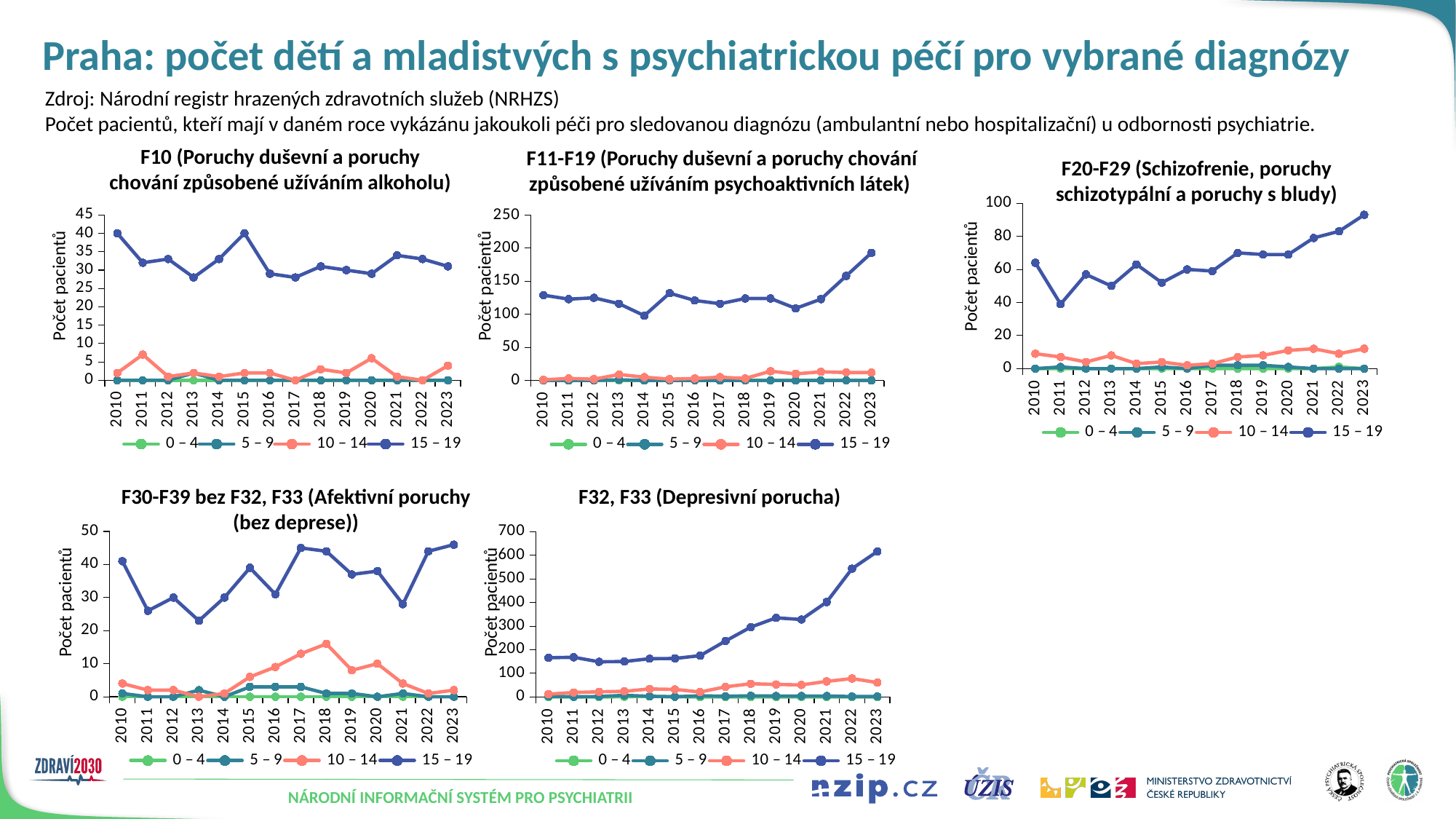
In the F32, F33 (Depresivní porucha) chart, does the 15 – 19 series rise or fall from 2016 to 2023? rise In the F11-F19 (Poruchy duševní a poruchy chování způsobené užíváním psychoaktivních látek) chart, is the value for the 15 – 19 series in 2023 greater or less than 150? greater How many series does the legend of the F32, F33 (Depresivní porucha) chart list? 4 Which series is drawn in dark blue in the F10 (Poruchy duševní a poruchy chování způsobené užíváním alkoholu) chart? 15 – 19 In the F11-F19 (Poruchy duševní a poruchy chování způsobené užíváním psychoaktivních látek) chart, in which year is the 15 – 19 series lowest? 2014 In the F30-F39 bez F32, F33 (Afektivní poruchy (bez deprese)) chart, is the value for the 15 – 19 series in 2023 greater or less than 40? greater How many years are plotted on the x axis of the F20-F29 (Schizofrenie, poruchy schizotypální a poruchy s bludy) chart? 14 What kind of chart is the F10 (Poruchy duševní a poruchy chování způsobené užíváním alkoholu) chart? line chart In the F20-F29 (Schizofrenie, poruchy schizotypální a poruchy s bludy) chart, in which year is the 15 – 19 series highest? 2023 In the F20-F29 (Schizofrenie, poruchy schizotypální a poruchy s bludy) chart, is the value for the 15 – 19 series in 2011 greater or less than 50? less In the F30-F39 bez F32, F33 (Afektivní poruchy (bez deprese)) chart, which is larger for the 10 – 14 series: the value in 2010 or the value in 2018? 2018